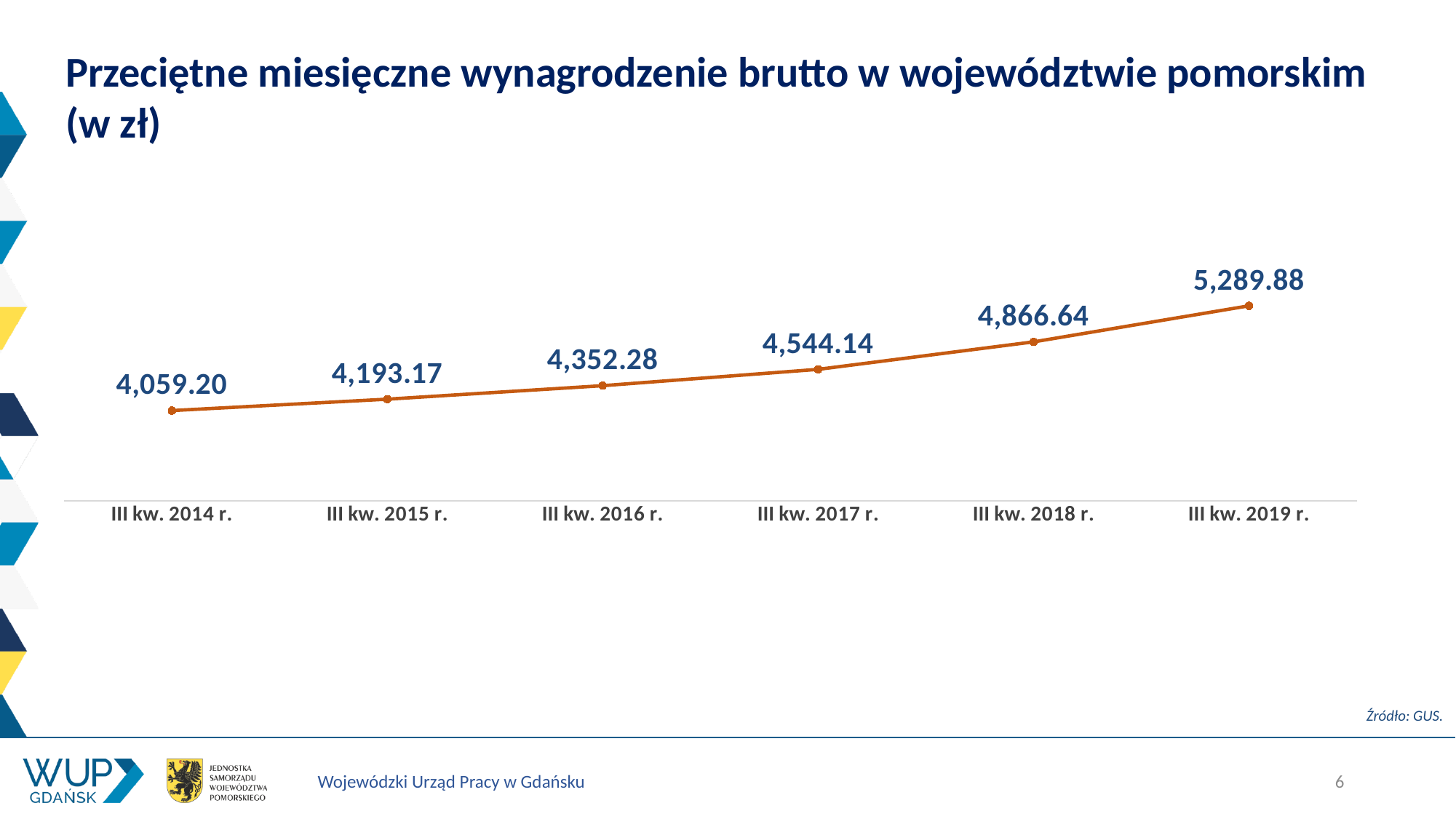
Which period has the highest value? III kw. 2019 r. What is the average monthly gross wage for III kw. 2014 r.? 4,059.20 Which is larger, the value for III kw. 2016 r. or III kw. 2015 r.? III kw. 2016 r. Which period has the lowest value? III kw. 2014 r. What is the difference between the values for III kw. 2019 r. and III kw. 2014 r.? 1,230.68 How many data points are plotted on the chart? 6 What value is shown for III kw. 2019 r.? 5,289.88 What value is shown for III kw. 2017 r.? 4,544.14 What is the difference between the values for III kw. 2018 r. and III kw. 2017 r.? 322.50 Do the values rise or fall from III kw. 2014 r. to III kw. 2019 r.? Rise What source is cited for the chart data? GUS What kind of chart is shown on the slide? Line chart